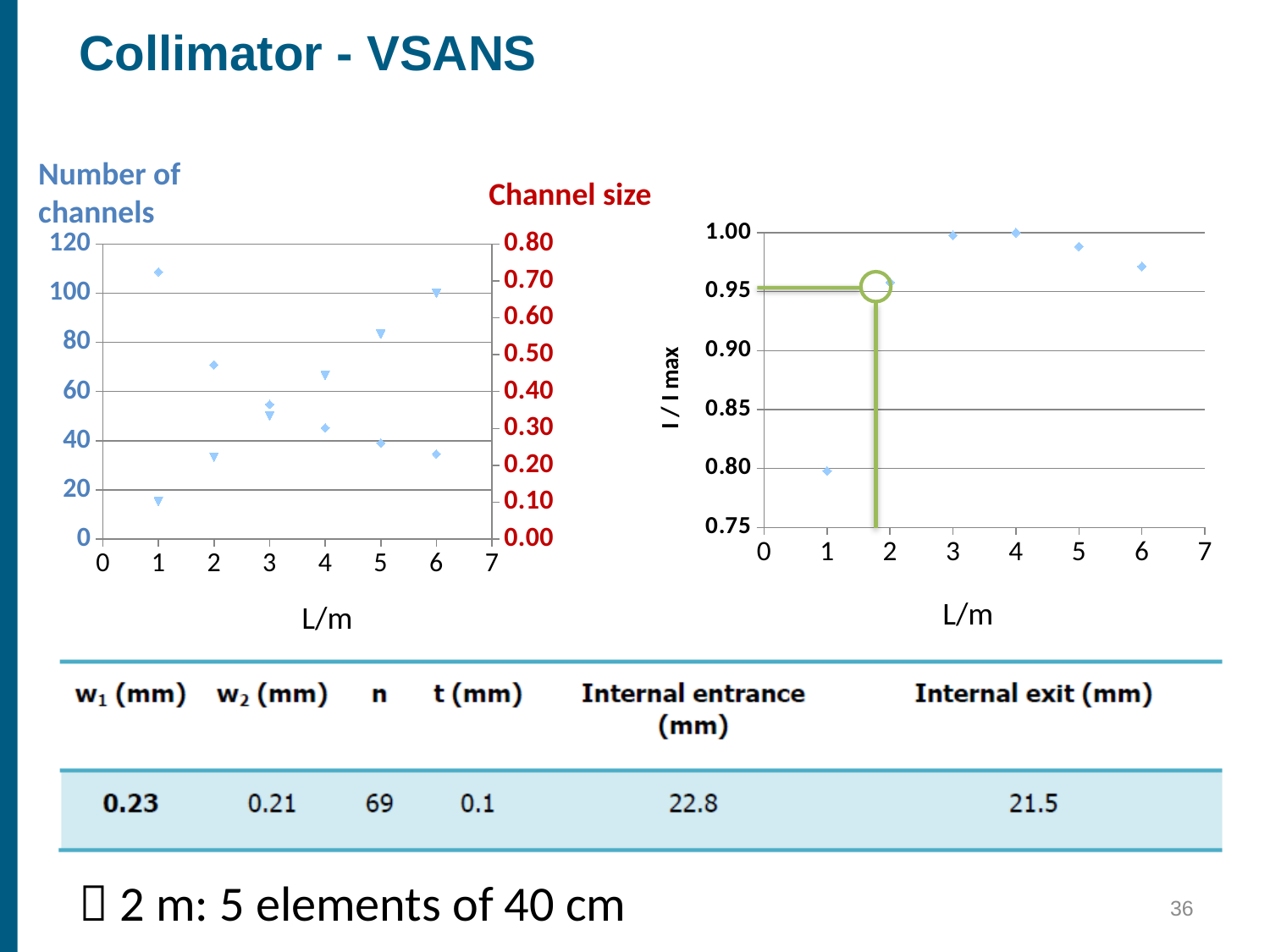
In the right-hand chart (I / I max versus L/m), how many data points are plotted? 6 In the left-hand chart, is the number of channels at L/m = 6 greater or less than 40? less In the left-hand chart, at which L/m value is the number of channels highest? 1 What kind of chart is the right-hand chart (I / I max versus L/m)? scatter chart In the right-hand chart (I / I max versus L/m), does I / I max rise or fall from L/m = 1 to L/m = 4? rise In the left-hand chart, is the channel size at L/m = 6 greater or less than 0.60? greater In the left-hand chart, does the number of channels rise or fall as L/m increases? fall In the right-hand chart (I / I max versus L/m), is the value at L/m = 3 greater or less than 0.95? greater In the left-hand chart, does the channel size rise or fall as L/m increases? rise In the right-hand chart (I / I max versus L/m), at which L/m value is I / I max lowest? 1